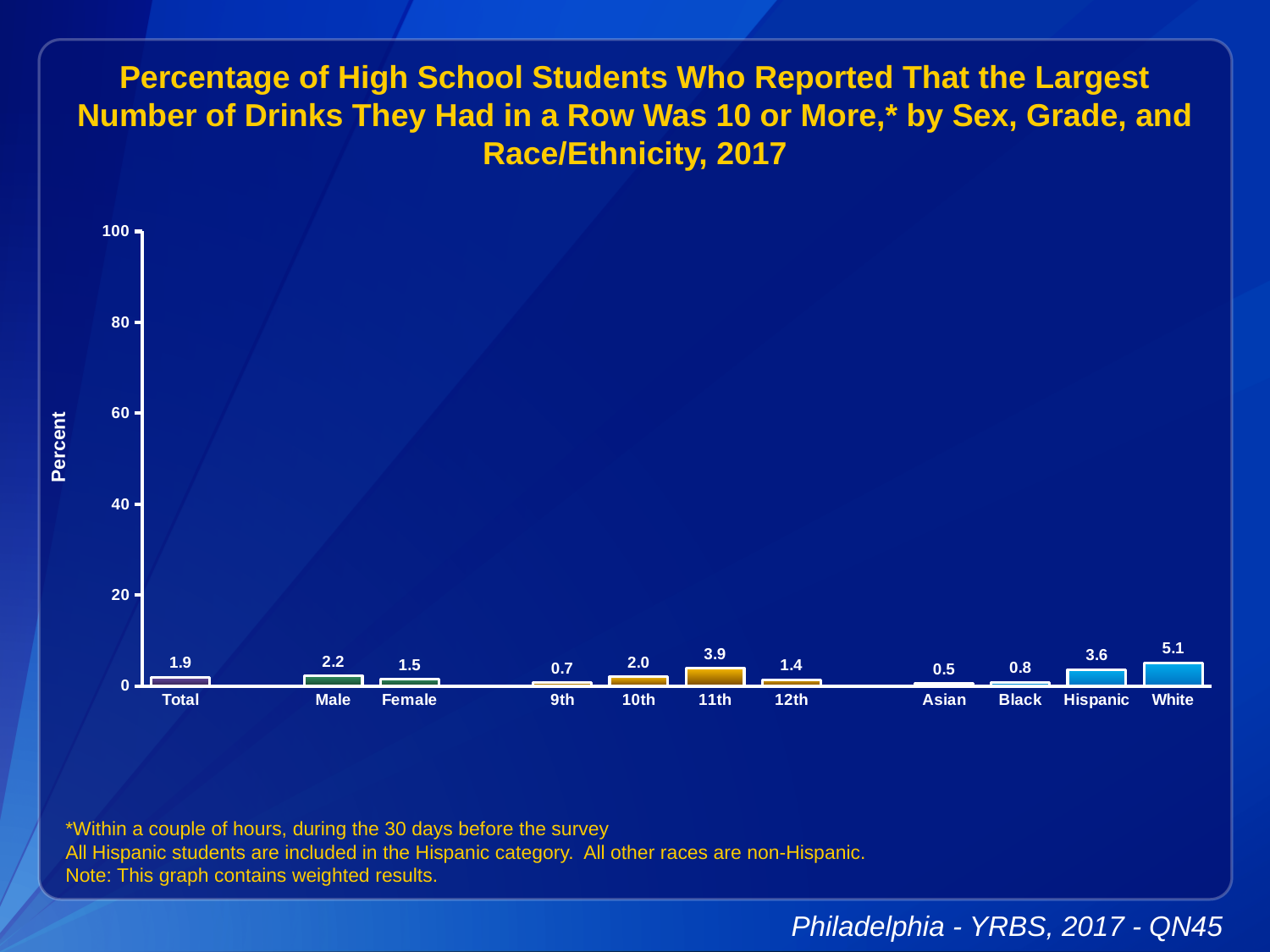
What is the label on the y axis? Percent Which is larger, the value for 10th grade or 12th grade? 10th What kind of chart is shown? Bar chart Which category has the lowest value? Asian What percentage is shown for Male students? 2.2 What is the difference between the values for Male and Female? 0.7 How many categories are plotted on the chart? 11 What is the difference between the values for White and Hispanic? 1.5 Which category has the highest value? White What is the value for 11th grade? 3.9 What is the value for Total? 1.9 What is the value for Asian students? 0.5